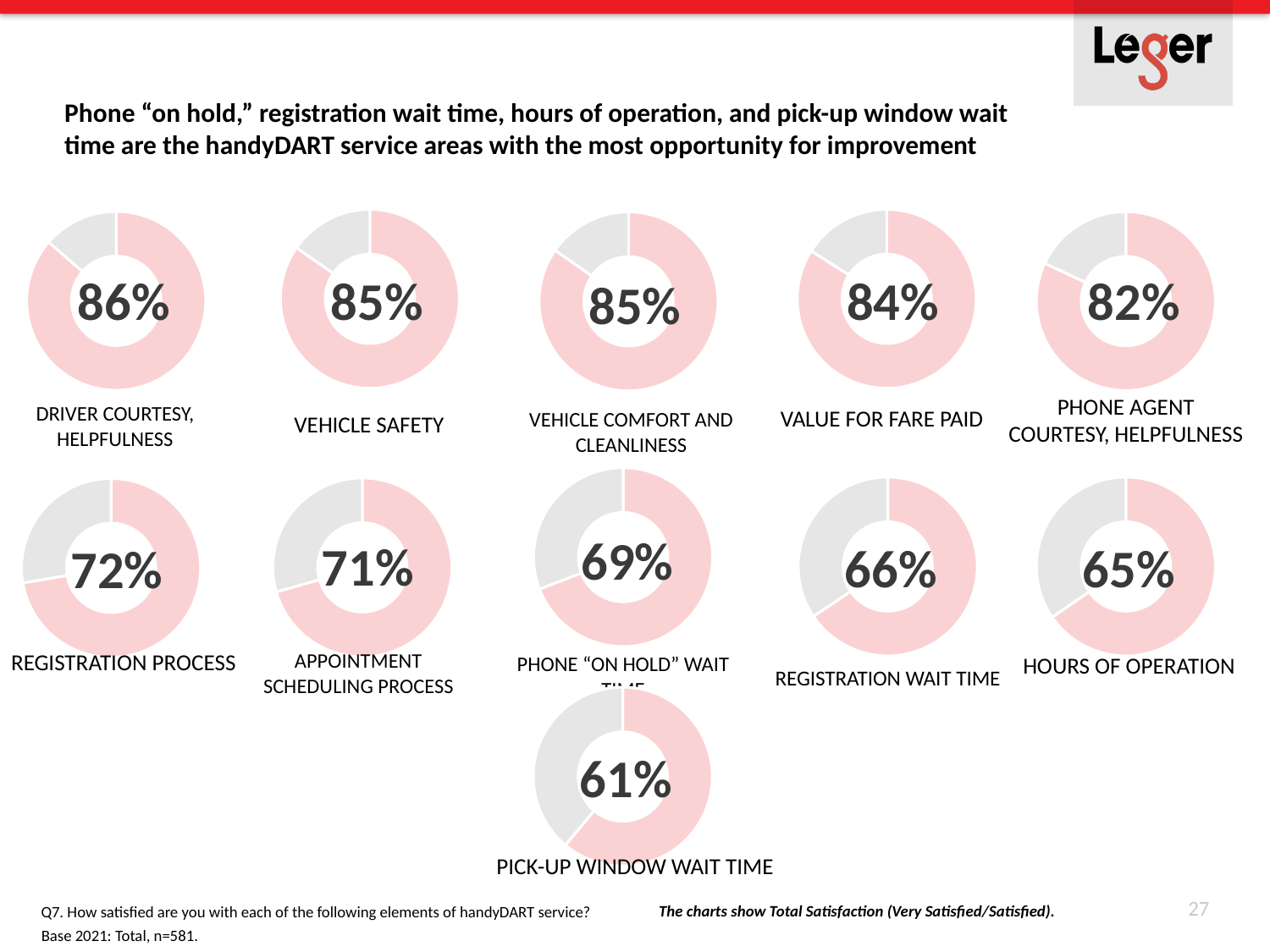
Across all the donut charts on the slide, which service area has the highest satisfaction percentage? Driver Courtesy, Helpfulness On the Hours of Operation chart, what percentage is shown? 65% How many donut charts are shown on the slide? 11 On the Driver Courtesy, Helpfulness chart, what is the total satisfaction percentage shown? 86% Across all the donut charts on the slide, which service area has the lowest satisfaction percentage? Pick-Up Window Wait Time What is the difference between the percentage on the Registration Process chart and the percentage on the Registration Wait Time chart? 6% What is the difference between the percentage on the Driver Courtesy, Helpfulness chart and the percentage on the Pick-Up Window Wait Time chart? 25% On the Phone "On Hold" Wait Time chart, what share of the donut is shown as satisfied? 69% On the Pick-Up Window Wait Time chart, what percentage is shown? 61% On the Value for Fare Paid chart, what percentage is shown? 84% What kind of chart is used for each service area on the slide? Donut chart Which chart shows a larger percentage: Phone Agent Courtesy, Helpfulness or Appointment Scheduling Process? Phone Agent Courtesy, Helpfulness